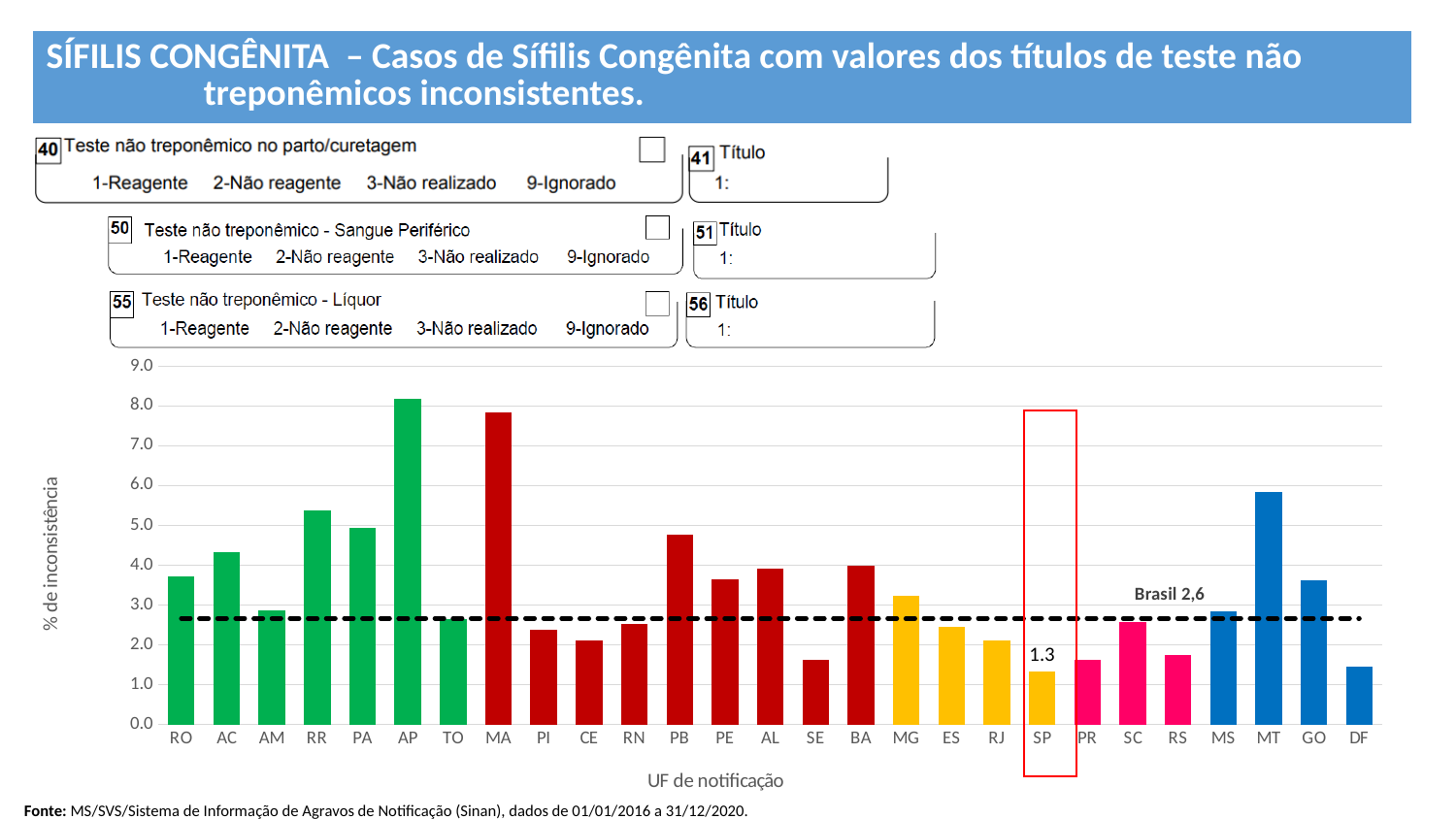
What type of chart is shown on the slide? bar chart Is the value for MT greater or less than 5.0? greater What is the value for SP? 1.3 Is the value for SE greater or less than 2.0? less Which is larger, the value for RR or the value for PA? RR Which UF has the highest % de inconsistência? AP Is the value for AP greater or less than 8.0? greater Which is larger, the value for MT or the value for GO? MT What is the label of the x axis? UF de notificação Which UF has the lowest % de inconsistência? SP What value is shown for Brasil by the dashed reference line? 2,6 How many UFs are plotted on the x axis? 27